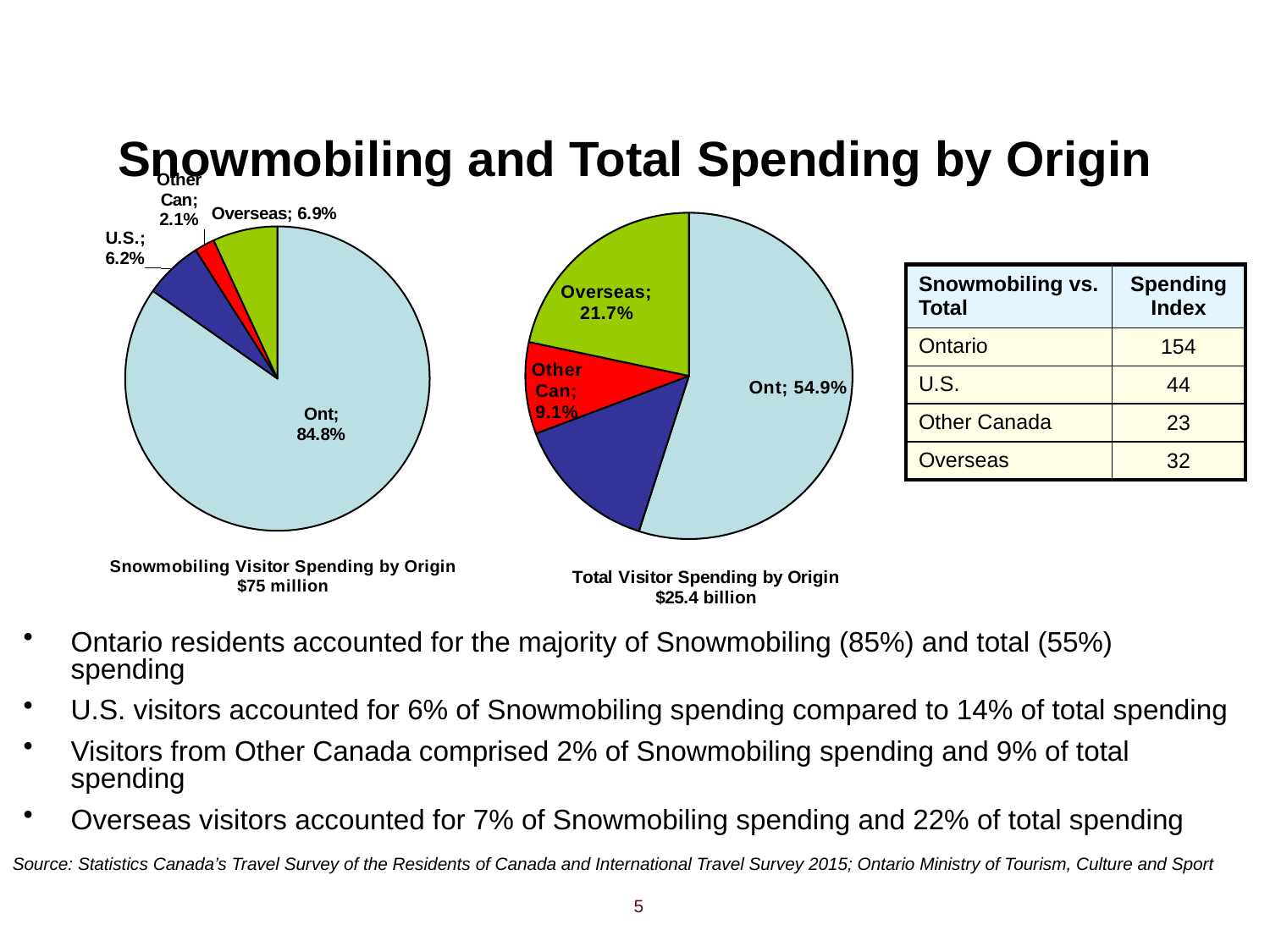
What is the difference between Ontario's share in the Snowmobiling Visitor Spending chart and its share in the Total Visitor Spending chart? 29.9 percentage points In the Total Visitor Spending by Origin chart, what share of spending comes from Overseas visitors? 21.7% How many slices does the Snowmobiling Visitor Spending by Origin pie chart have? 4 In the Snowmobiling Visitor Spending by Origin chart, which is larger: the U.S. slice or the Overseas slice? Overseas What total amount is shown under the Snowmobiling Visitor Spending by Origin chart? $75 million In the Snowmobiling Visitor Spending by Origin chart, what share of spending comes from Overseas visitors? 6.9% In the Snowmobiling Visitor Spending by Origin chart, which origin has the smallest slice? Other Can What total amount is shown under the Total Visitor Spending by Origin chart? $25.4 billion In the Total Visitor Spending by Origin chart, which origin has the largest slice? Ont In the Total Visitor Spending by Origin chart, what share of spending comes from Other Canada? 9.1% What type of chart is used for Total Visitor Spending by Origin? Pie chart In the Snowmobiling Visitor Spending by Origin chart, what share of spending comes from Ontario? 84.8%